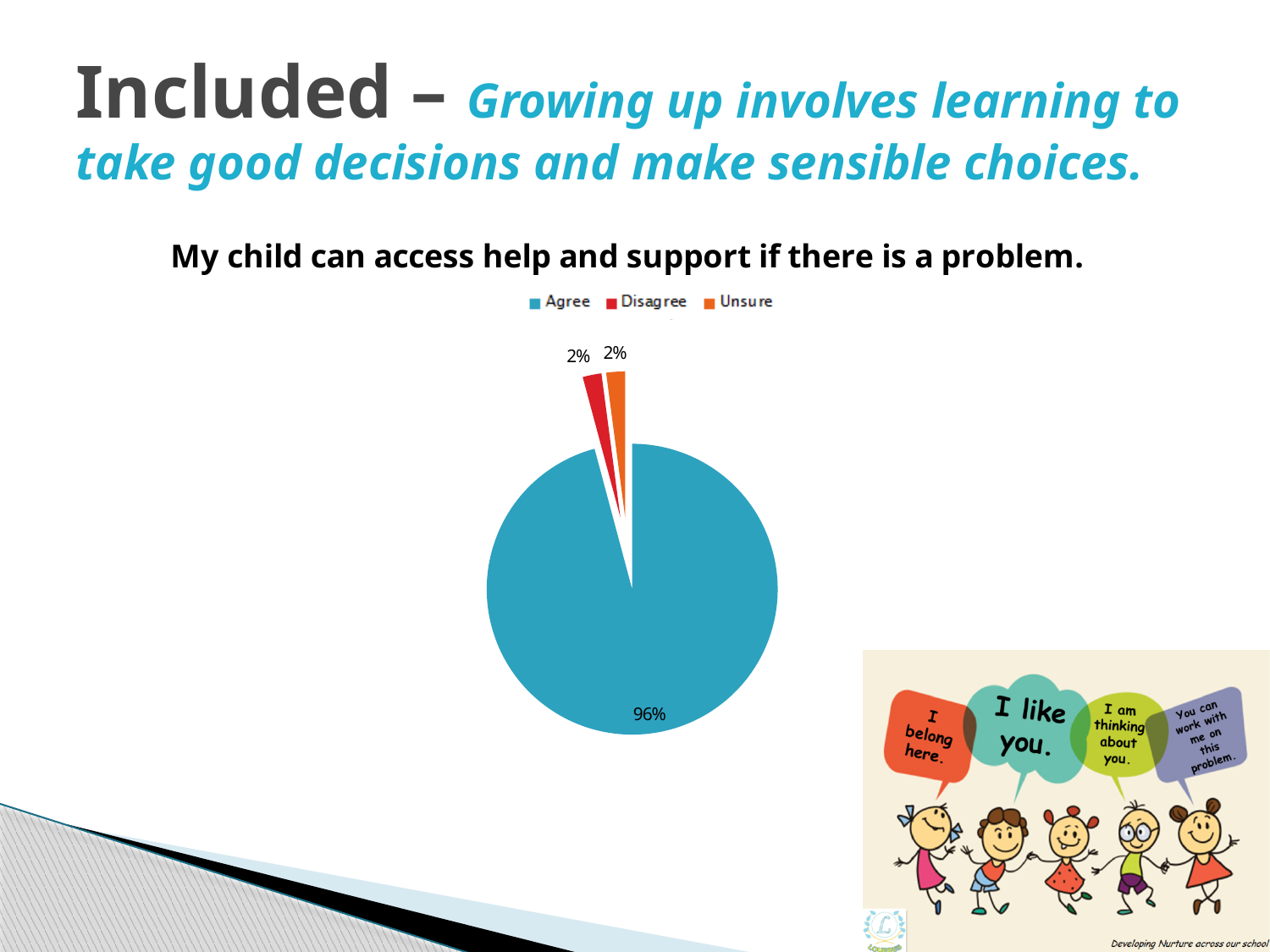
What is the difference between the Agree share and the Disagree share? 94% What percentage of respondents chose Disagree? 2% How many slices does the pie chart have? 3 What statement is the pie chart about? My child can access help and support if there is a problem. Which is larger, the Agree share or the Unsure share? Agree How many categories does the legend list? 3 Which response has the largest share of the pie? Agree What is the combined share of Disagree and Unsure? 4% What colour is the Agree slice? blue What percentage of respondents chose Unsure? 2% What percentage of respondents chose Agree? 96% What kind of chart is shown on the slide? pie chart